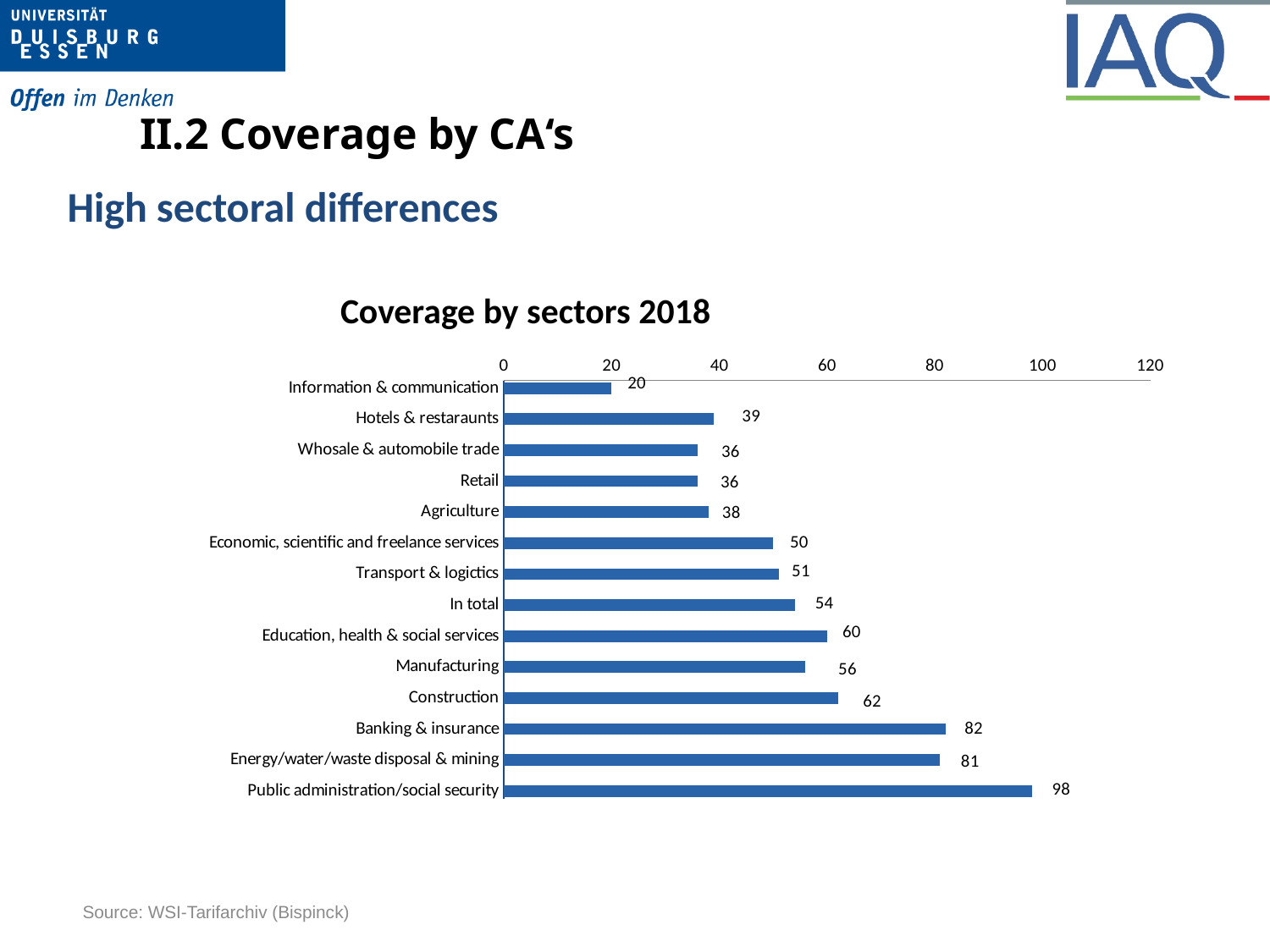
How many categories are shown in the chart? 14 Which is larger, Education, health & social services or Transport & logictics? Education, health & social services What kind of chart is this? bar chart What is the title of the chart? Coverage by sectors 2018 What is the difference between Public administration/social security and Information & communication? 78 What is the value for In total? 54 What is the difference between Banking & insurance and Construction? 20 Is the value for Energy/water/waste disposal & mining greater or less than 60? greater Which sector has the highest coverage? Public administration/social security What is the value for Public administration/social security? 98 Which sector has the lowest coverage? Information & communication What is the value for Manufacturing? 56